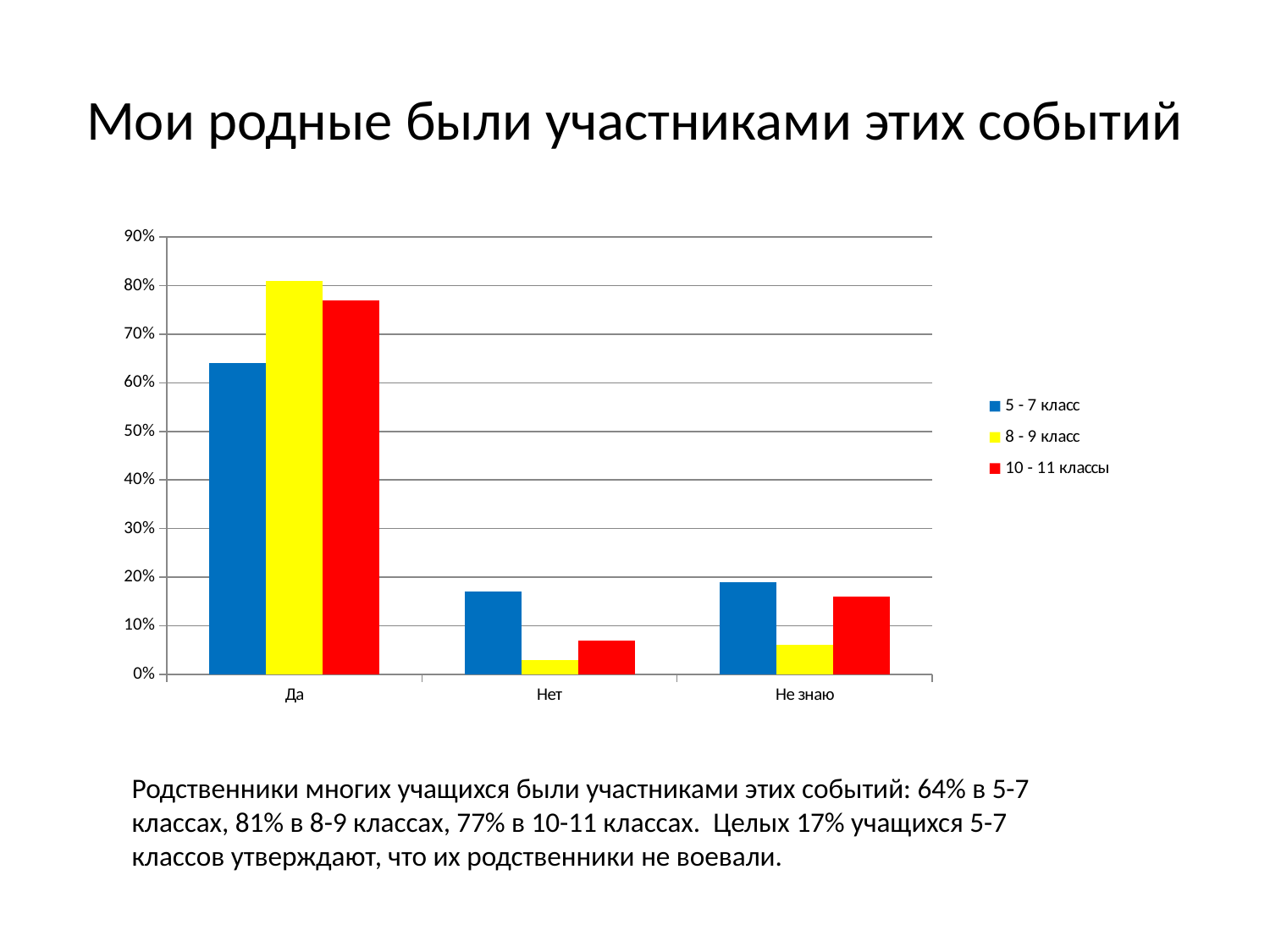
What is the value for 5 - 7 класс in the Да category? 64% What kind of chart is shown on the slide? bar chart What is the value for 10 - 11 классы in the Да category? 77% What is the difference between the 8 - 9 класс and 5 - 7 класс values in the Да category? 17% Is the value for 5 - 7 класс in the Не знаю category greater or less than 10%? greater Which series has the lowest value in the Нет category? 8 - 9 класс How many categories are shown on the x axis? 3 How many series does the legend list? 3 What is the value for 5 - 7 класс in the Нет category? 17% What is the value for 8 - 9 класс in the Да category? 81% Which is larger in the Не знаю category: 8 - 9 класс or 10 - 11 классы? 10 - 11 классы Which series has the highest value in the Да category? 8 - 9 класс